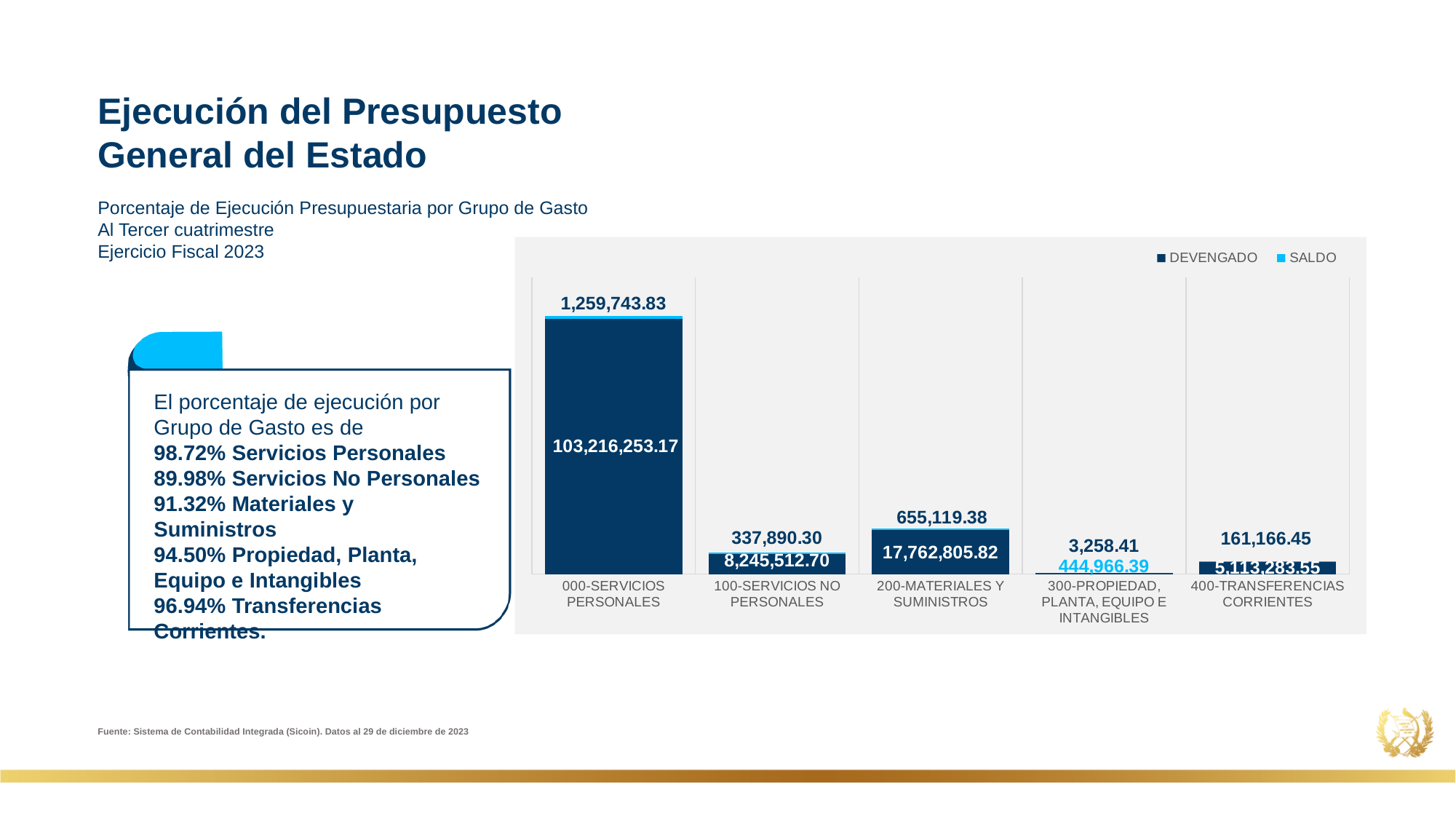
How many series does the legend list? 2 What is the DEVENGADO value for 000-SERVICIOS PERSONALES? 103,216,253.17 Which is larger, the DEVENGADO value for 400-TRANSFERENCIAS CORRIENTES or for 100-SERVICIOS NO PERSONALES? 100-SERVICIOS NO PERSONALES What is the DEVENGADO value for 300-PROPIEDAD, PLANTA, EQUIPO E INTANGIBLES? 444,966.39 What is the SALDO value for 400-TRANSFERENCIAS CORRIENTES? 161,166.45 What is the difference between the DEVENGADO values for 200-MATERIALES Y SUMINISTROS and 100-SERVICIOS NO PERSONALES? 9,517,293.12 What is the SALDO value for 200-MATERIALES Y SUMINISTROS? 655,119.38 Which category has the lowest SALDO value? 300-PROPIEDAD, PLANTA, EQUIPO E INTANGIBLES How many categories are shown on the x axis? 5 What kind of chart is shown on the slide? Stacked bar chart Which category has the highest DEVENGADO value? 000-SERVICIOS PERSONALES What is the total of the stacked bar for 100-SERVICIOS NO PERSONALES? 8,583,403.00